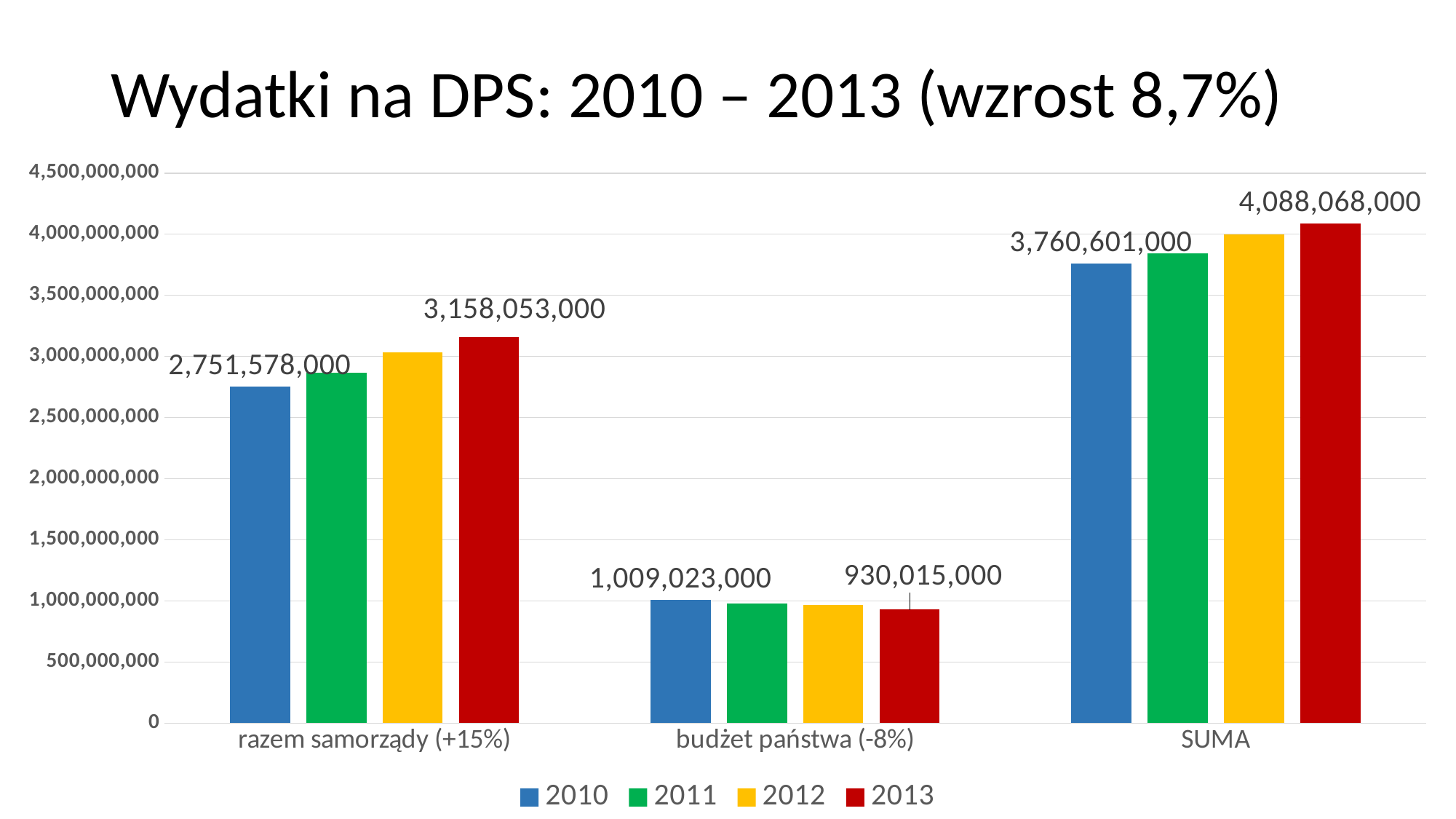
Is the 2011 value in the 'SUMA' category greater or less than 4,000,000,000? less How many series does the legend list? 4 What is the title of the chart? Wydatki na DPS: 2010 – 2013 (wzrost 8,7%) What is the difference between the 2010 and 2013 values in the 'budżet państwa (-8%)' category? 79,008,000 What kind of chart is shown on the slide? bar chart What is the value for 2010 in the 'razem samorządy (+15%)' category? 2,751,578,000 What is the difference between the 2013 and 2010 values in the 'SUMA' category? 327,467,000 What is the value for 2010 in the 'budżet państwa (-8%)' category? 1,009,023,000 What is the value for 2013 in the 'SUMA' category? 4,088,068,000 What is the value for 2013 in the 'razem samorządy (+15%)' category? 3,158,053,000 Which is larger in the 'budżet państwa (-8%)' category: the 2010 value or the 2013 value? 2010 What is the value for 2013 in the 'budżet państwa (-8%)' category? 930,015,000